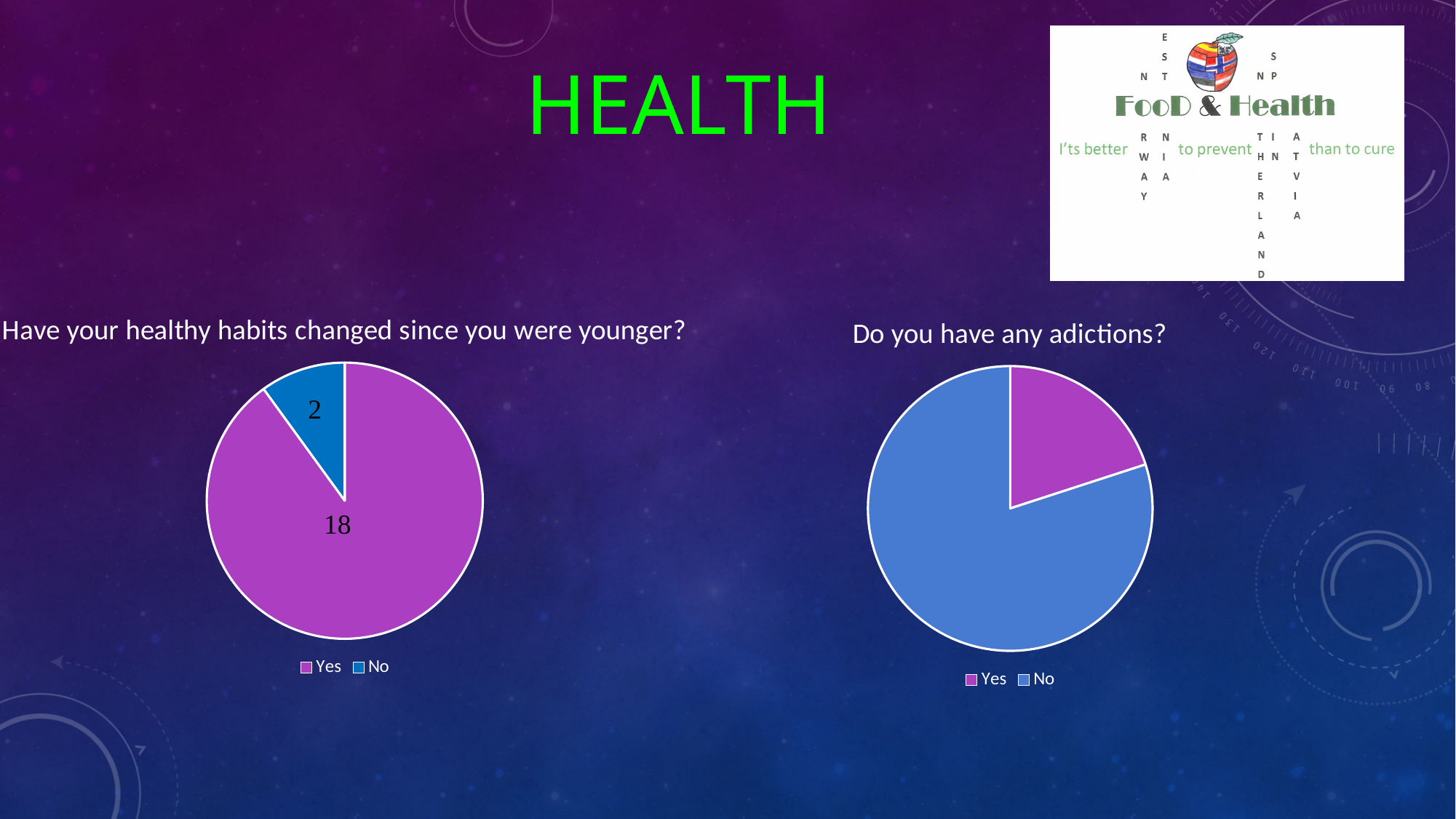
In the chart titled "Have your healthy habits changed since you were younger?", which category has the largest slice? Yes In the chart titled "Have your healthy habits changed since you were younger?", which category has the smallest slice? No In the chart titled "Do you have any adictions?", is the Yes slice or the No slice larger? No What kind of chart is the chart titled "Have your healthy habits changed since you were younger?"? Pie chart In the chart titled "Have your healthy habits changed since you were younger?", what is the difference between the Yes and No values? 16 In the chart titled "Have your healthy habits changed since you were younger?", what is the total of all slices? 20 In the chart titled "Have your healthy habits changed since you were younger?", what value is shown for Yes? 18 In the chart titled "Have your healthy habits changed since you were younger?", what value is shown for No? 2 How many categories does the legend list in the chart titled "Do you have any adictions?"? 2 In the chart titled "Do you have any adictions?", what colour is the Yes slice? Purple In the chart titled "Do you have any adictions?", which category has the largest slice? No In the chart titled "Have your healthy habits changed since you were younger?", what share of the pie does the Yes slice represent? 90%